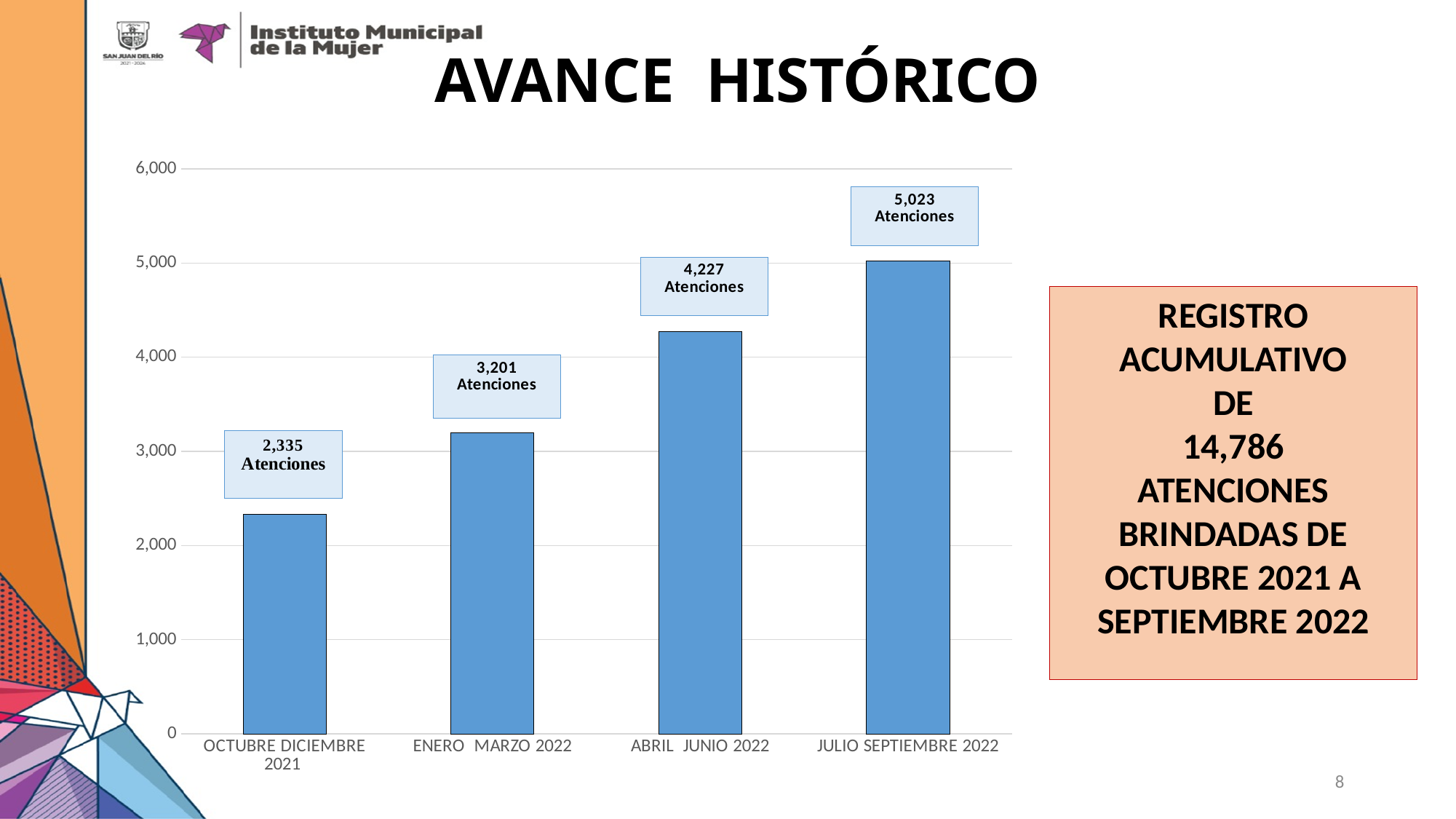
What is the value for ENERO MARZO 2022? 3,201 Which period has the highest value? JULIO SEPTIEMBRE 2022 What is the difference between the values for ABRIL JUNIO 2022 and ENERO MARZO 2022? 1,026 What kind of chart is shown on the slide? Bar chart Which is larger, the value for ENERO MARZO 2022 or the value for ABRIL JUNIO 2022? ABRIL JUNIO 2022 What is the value for OCTUBRE DICIEMBRE 2021? 2,335 Do the values rise or fall from left to right along the x axis? Rise Which period has the lowest value? OCTUBRE DICIEMBRE 2021 What is the difference between the values for JULIO SEPTIEMBRE 2022 and OCTUBRE DICIEMBRE 2021? 2,688 What is the value for ABRIL JUNIO 2022? 4,227 What is the value for JULIO SEPTIEMBRE 2022? 5,023 How many periods are shown on the x axis? 4